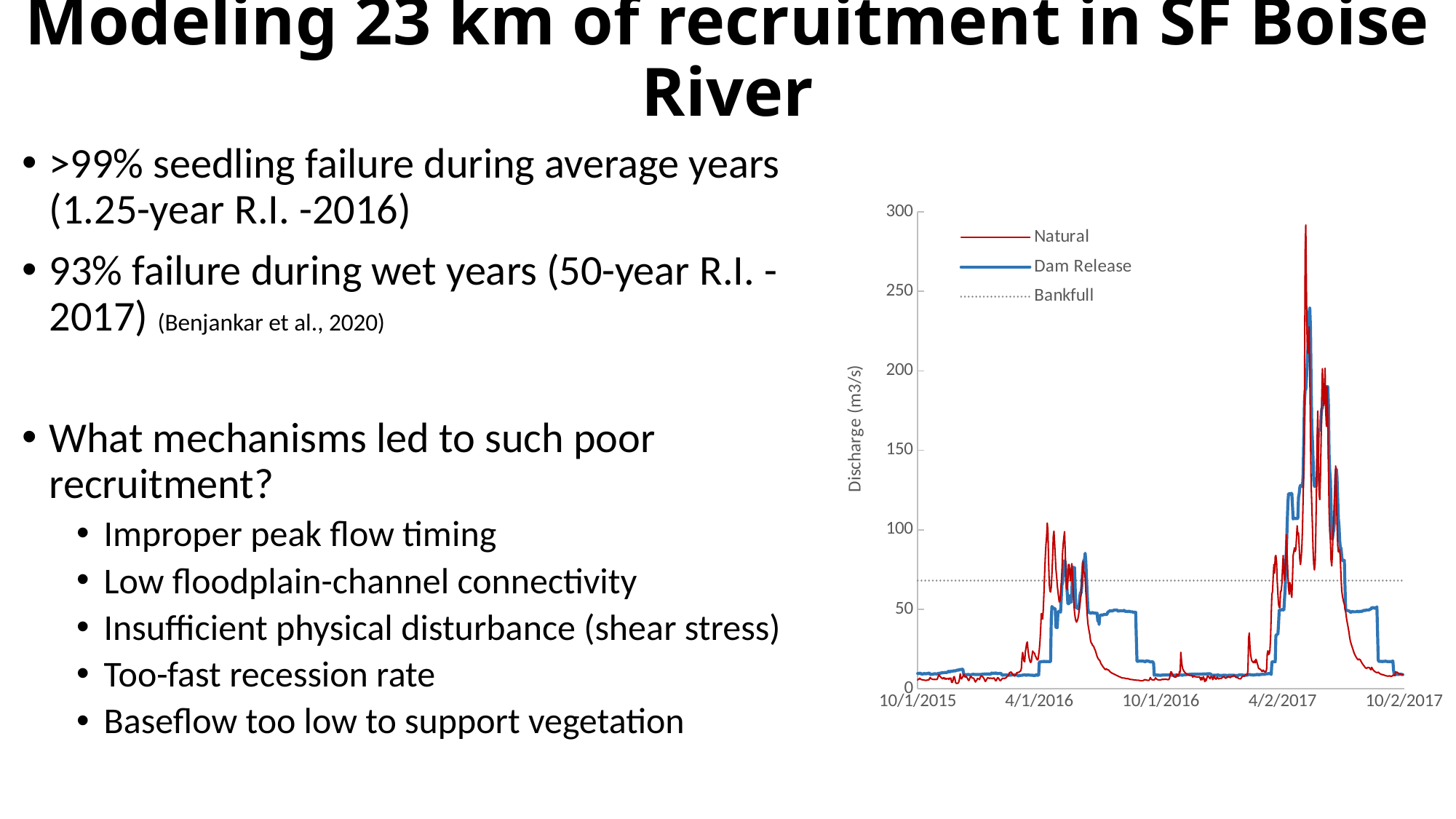
Which spring has the higher peak discharge in the chart, 2016 or 2017? 2017 How many date labels are shown on the chart's horizontal axis? 5 Is the highest peak of the Dam Release series greater or less than 200 m3/s? greater Which series reaches a higher maximum discharge, Natural or Dam Release? Natural Is the Bankfull line greater or less than 100 m3/s? less What kind of chart is shown on the slide? line chart What is the label of the chart's vertical axis? Discharge (m3/s) Is the peak of the Natural series in spring 2016 greater or less than 150 m3/s? less What are the three series named in the chart legend? Natural, Dam Release, Bankfull How many series does the chart legend list? 3